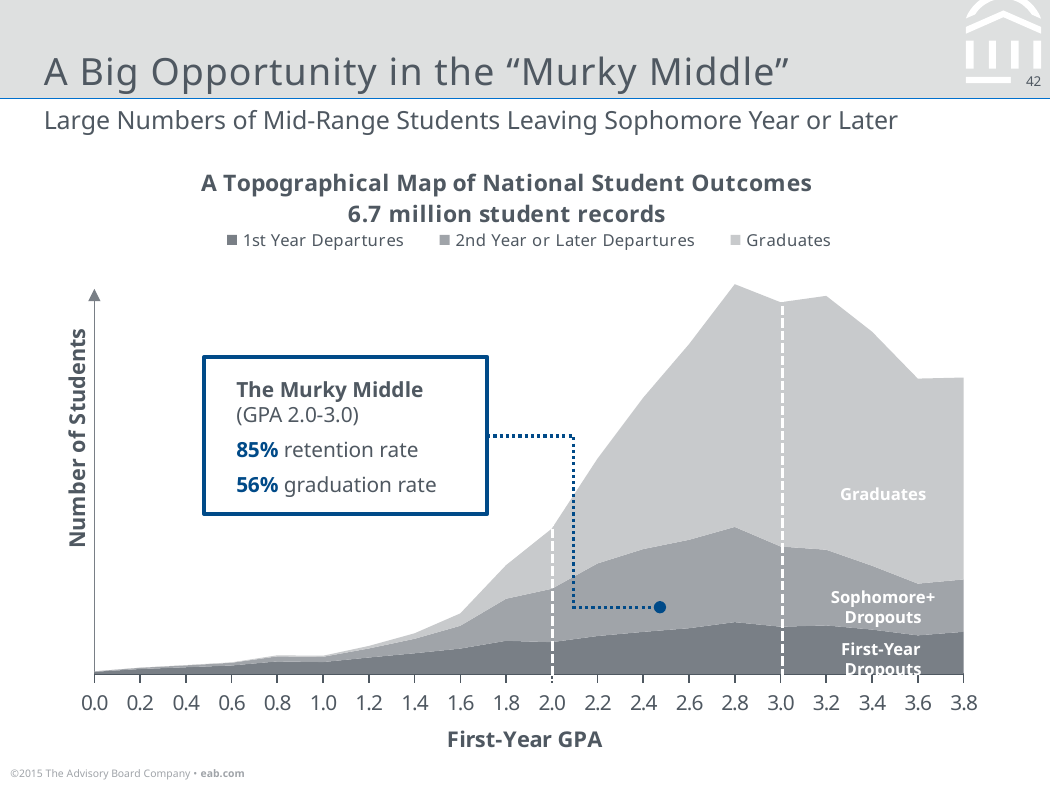
Does the total number of students rise or fall as first-year GPA increases from 2.8 to 3.8? Fall What retention rate does the chart callout give for the Murky Middle (GPA 2.0-3.0)? 85% At which first-year GPA does the total number of students reach its peak? 2.8 What are the three series listed in the chart legend? 1st Year Departures, 2nd Year or Later Departures, Graduates How many GPA tick labels are shown along the x axis? 20 Does the total number of students rise or fall as first-year GPA increases from 0.0 to 2.8? Rise What kind of chart is shown on the slide? Stacked area chart What is the label on the x axis of the chart? First-Year GPA What graduation rate does the chart callout give for the Murky Middle (GPA 2.0-3.0)? 56% How many series does the chart legend list? 3 At which first-year GPA is the total number of students lowest? 0.0 Is the total number of students larger at a first-year GPA of 3.0 or at 1.0? 3.0